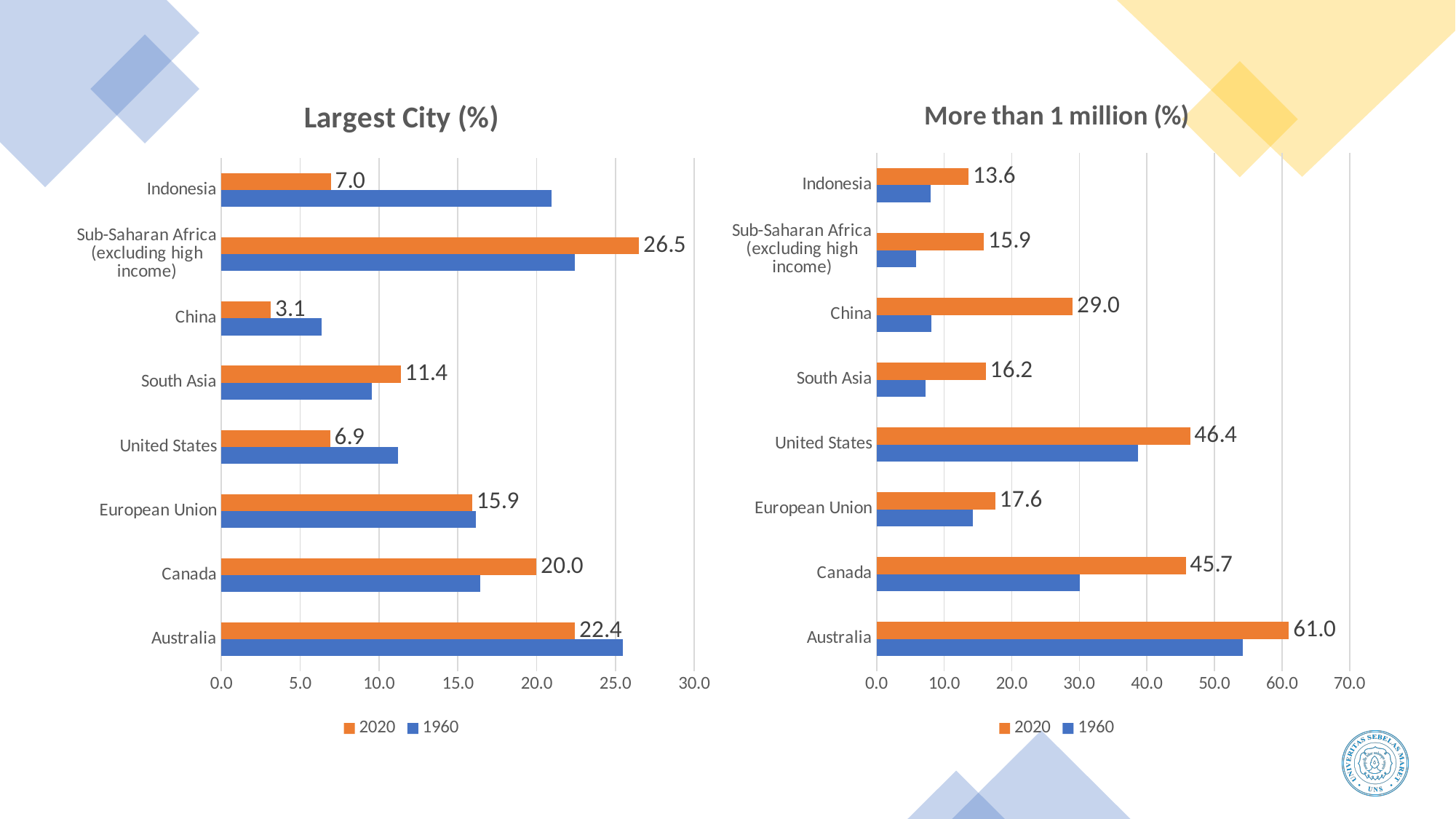
In the 'Largest City (%)' chart, what is the difference between the 2020 values for Canada and Indonesia? 13.0 In the 'Largest City (%)' chart, which category has the lowest 2020 value? China In the 'More than 1 million (%)' chart, what is the 2020 value for the United States? 46.4 In the 'More than 1 million (%)' chart, what is the difference between the 2020 values for Australia and China? 32.0 In the 'More than 1 million (%)' chart, which category has the highest 2020 value? Australia In the 'Largest City (%)' chart, what is the 2020 value for Sub-Saharan Africa (excluding high income)? 26.5 How many series does the legend of the 'Largest City (%)' chart list? 2 In the 'More than 1 million (%)' chart, is the 1960 value for Australia greater or less than 50.0? greater What type of chart is the 'Largest City (%)' chart? Bar chart In the 'Largest City (%)' chart, is the 1960 value for Indonesia greater or less than 20.0? greater How many categories are shown in the 'More than 1 million (%)' chart? 8 In the 'Largest City (%)' chart, which has the larger 2020 value, Australia or Canada? Australia